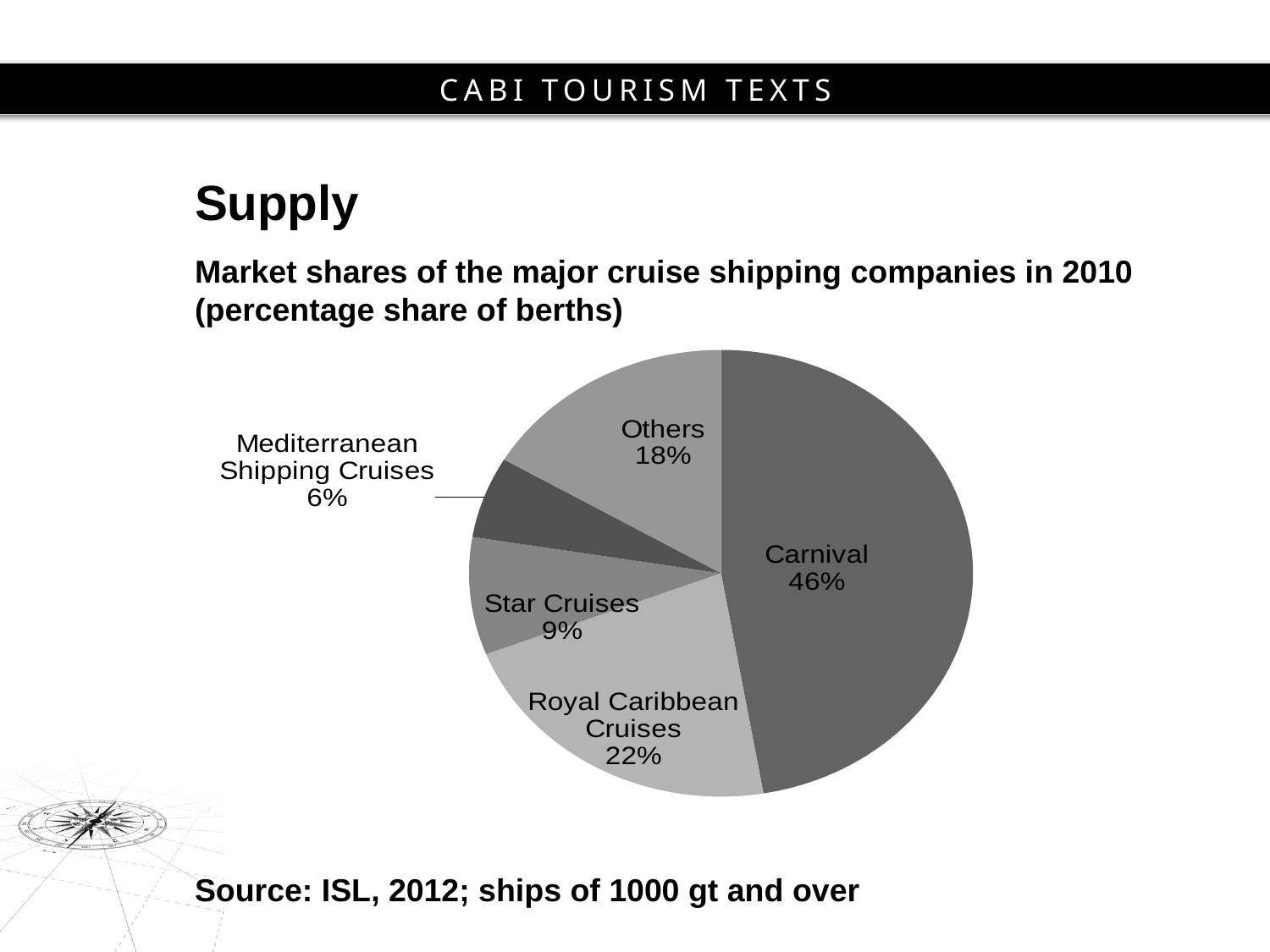
What is the market share of Mediterranean Shipping Cruises? 6% What is the market share of Carnival? 46% How many slices does the pie chart have? 5 Which slice of the pie is the smallest? Mediterranean Shipping Cruises Which has a larger market share, Star Cruises or Others? Others What year do the market shares in the chart refer to? 2010 What is the difference in market share between Carnival and Royal Caribbean Cruises? 24 percentage points What share of the pie is labelled Others? 18% What kind of chart is shown on the slide? pie chart What is the market share of Royal Caribbean Cruises? 22% What is the market share of Star Cruises? 9% Which company has the largest market share? Carnival